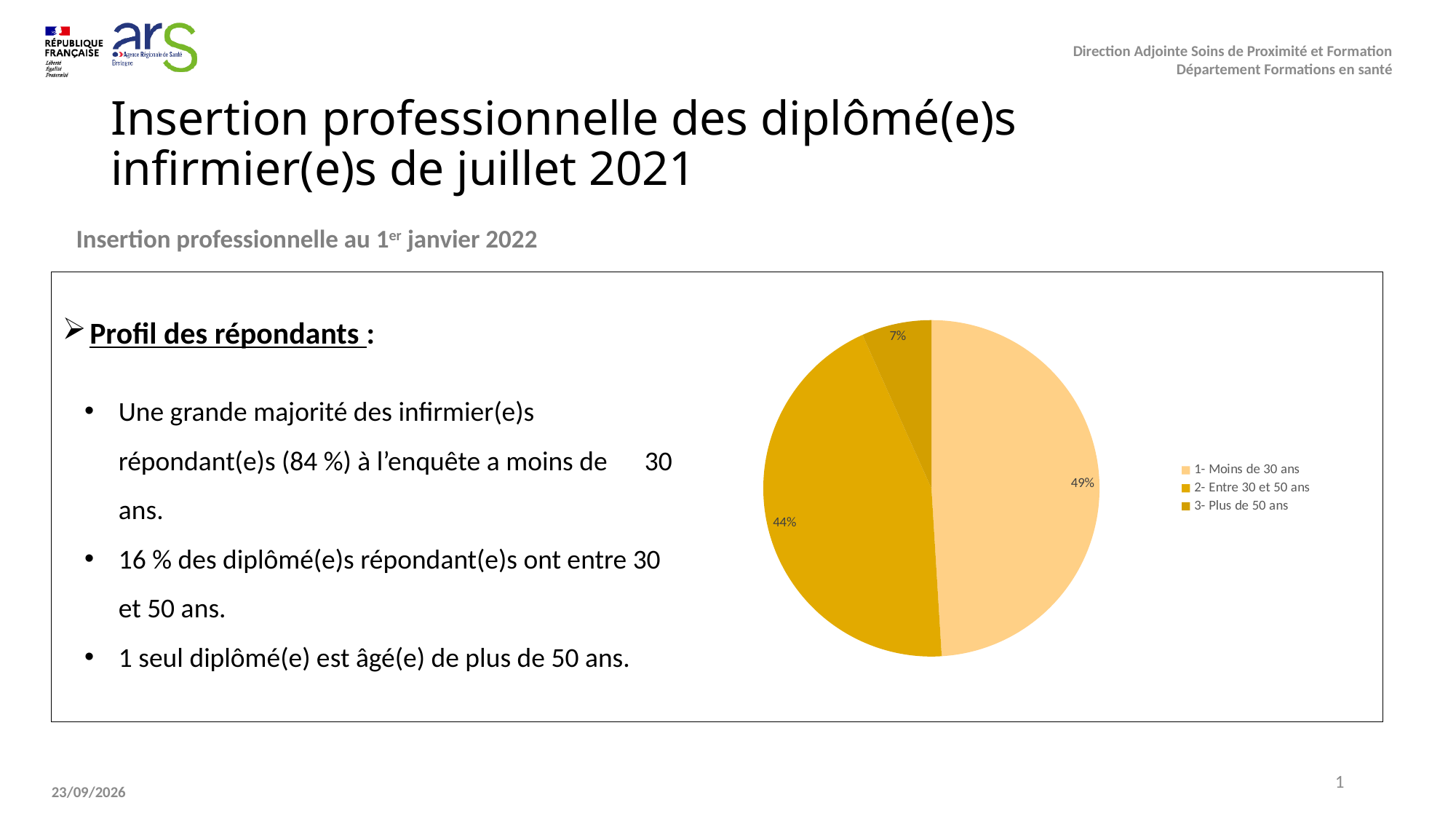
What share of the pie does the slice "2- Entre 30 et 50 ans" represent? 44% Which slice is larger: "2- Entre 30 et 50 ans" or "3- Plus de 50 ans"? 2- Entre 30 et 50 ans Which category has the largest slice of the pie? 1- Moins de 30 ans How many entries does the legend of the pie chart list? 3 Which category has the smallest slice of the pie? 3- Plus de 50 ans What kind of chart is shown on the slide? pie chart What is the difference in percentage points between the "2- Entre 30 et 50 ans" slice and the "3- Plus de 50 ans" slice? 37 percentage points What share of the pie does the slice "1- Moins de 30 ans" represent? 49% Which legend entry is shown with the lightest colour in the pie chart? 1- Moins de 30 ans How many categories does the pie chart show? 3 What is the difference in percentage points between the "1- Moins de 30 ans" slice and the "2- Entre 30 et 50 ans" slice? 5 percentage points What share of the pie does the slice "3- Plus de 50 ans" represent? 7%